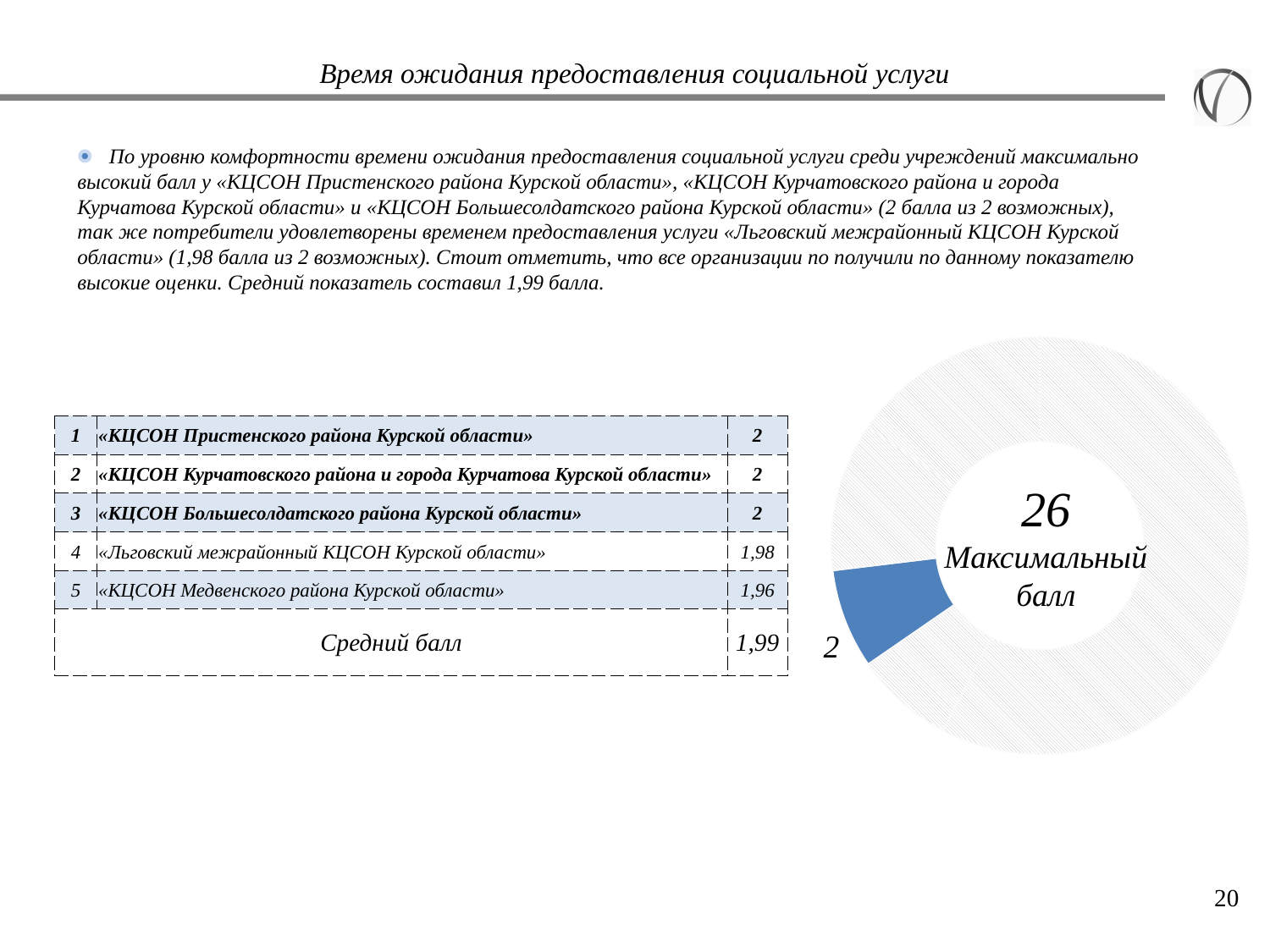
Is the blue slice of the doughnut chart less than half of the ring? Yes What value is printed next to the blue slice of the doughnut chart? 2 In the doughnut chart, which is larger: the blue slice or the hatched slice? The hatched slice What kind of chart is shown on the right side of the slide? Doughnut (pie) chart What text accompanies the number in the centre of the doughnut chart? Максимальный балл What number is printed in the centre of the doughnut chart? 26